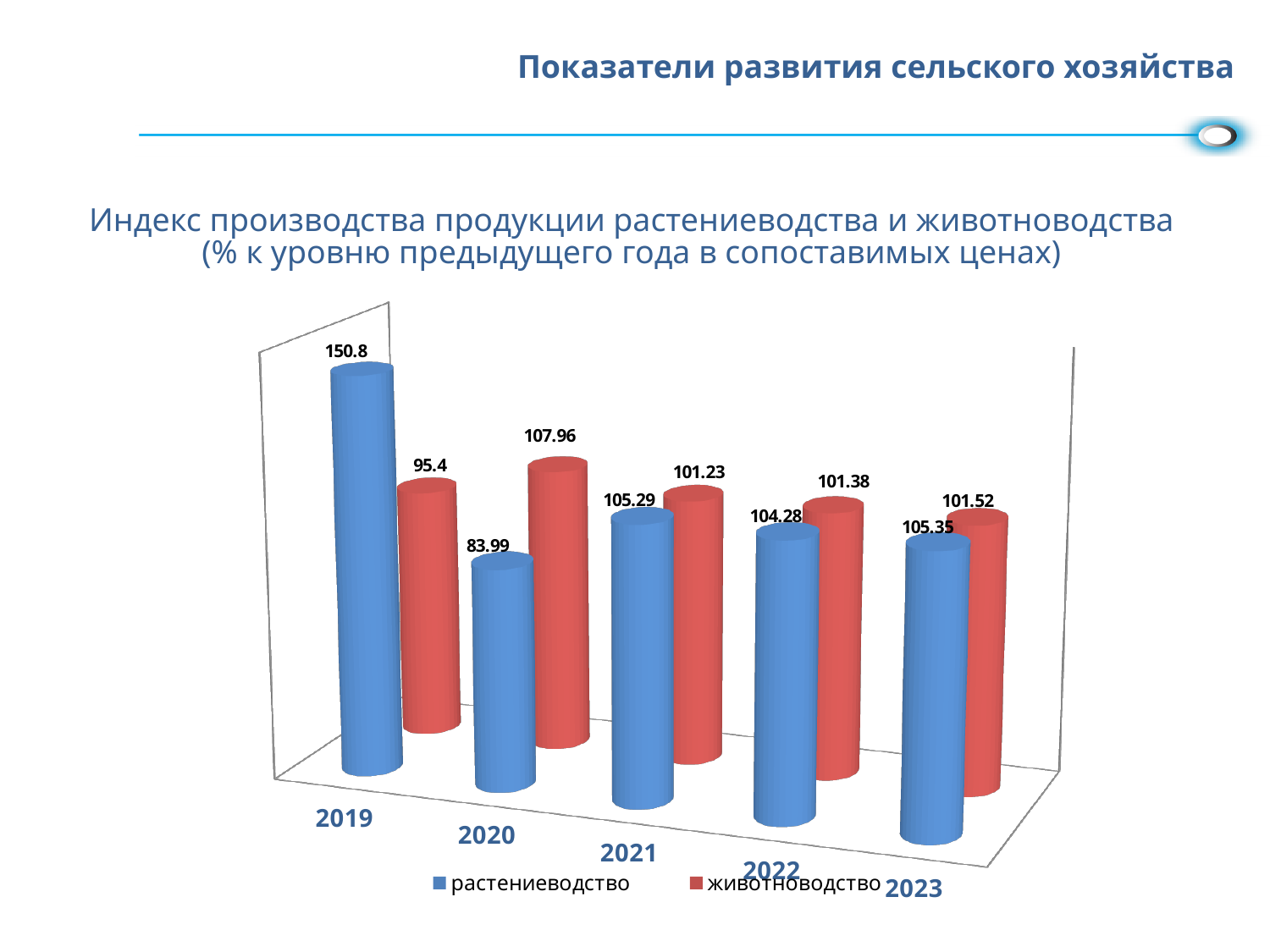
In which year is the животноводство value highest? 2020 What is the value for растениеводство in 2023? 105.35 What is the value for животноводство in 2020? 107.96 In which year is the растениеводство value lowest? 2020 How many series does the legend list? 2 In which year is the животноводство value lowest? 2019 What is the value for растениеводство in 2019? 150.8 What kind of chart is shown on the slide? bar chart How many years are shown on the x axis? 5 What is the difference between растениеводство and животноводство in 2019? 55.4 What is the difference between животноводство and растениеводство in 2020? 23.97 Which series has the larger value in 2022, растениеводство or животноводство? растениеводство